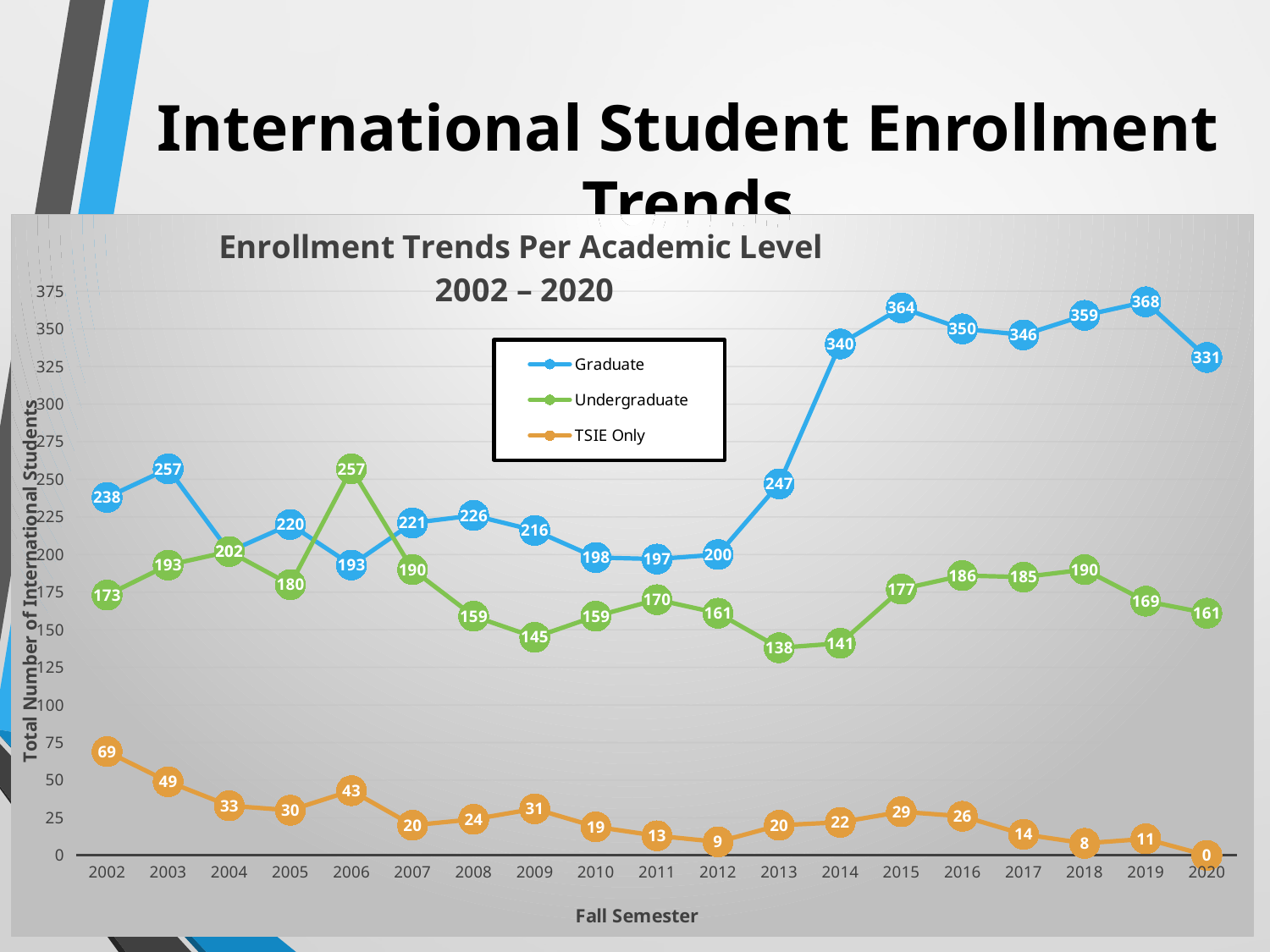
What is the label of the x axis? Fall Semester Is the Graduate value for 2015 greater or less than 350? greater What is the difference between the Graduate values for 2014 and 2013? 93 What is the Undergraduate enrollment value for 2013? 138 Which is larger in 2006, the Graduate value or the Undergraduate value? Undergraduate What kind of chart is shown on the slide? Line chart In which year is the TSIE Only series at its lowest? 2020 In which year is the Graduate series at its highest? 2019 How many years are plotted on the x axis? 19 What is the TSIE Only value for 2002? 69 What is the Graduate enrollment value for 2019? 368 How many series does the legend list? 3